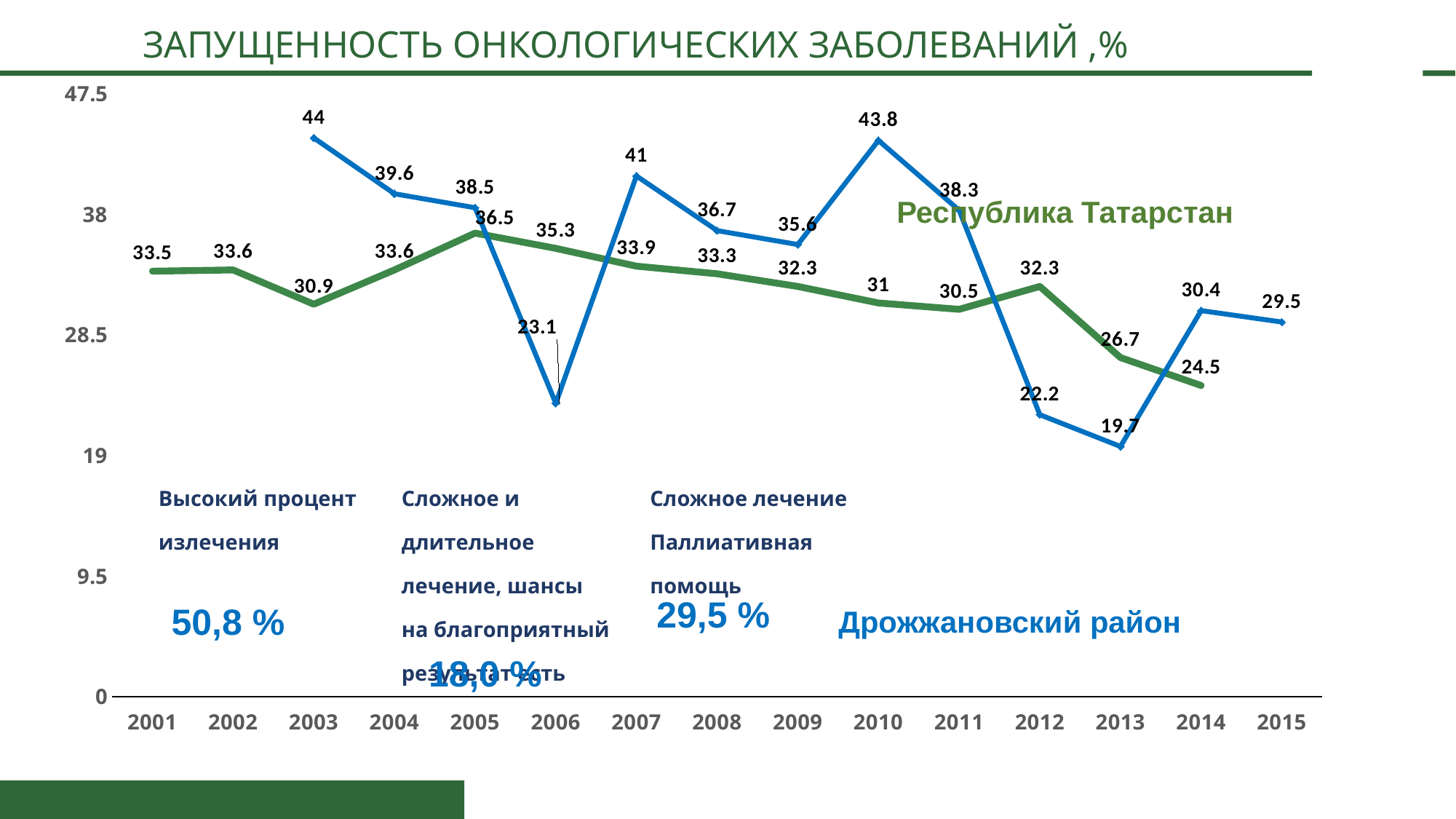
What type of chart is shown on the slide? Line chart What is the difference between Дрожжановский район and Республика Татарстан in 2010? 12.8 How many years are shown on the x axis? 15 What is the value for Республика Татарстан in 2014? 24.5 Which is larger in 2012: the value for Дрожжановский район or for Республика Татарстан? Республика Татарстан What colour is the line for Республика Татарстан? Green In which year does Республика Татарстан reach its highest value? 2005 How many data series are plotted on the chart? 2 What is the value for Дрожжановский район in 2006? 23.1 In which year does Дрожжановский район reach its lowest value? 2013 What is the value for Республика Татарстан in 2005? 36.5 What is the value for Дрожжановский район in 2003? 44